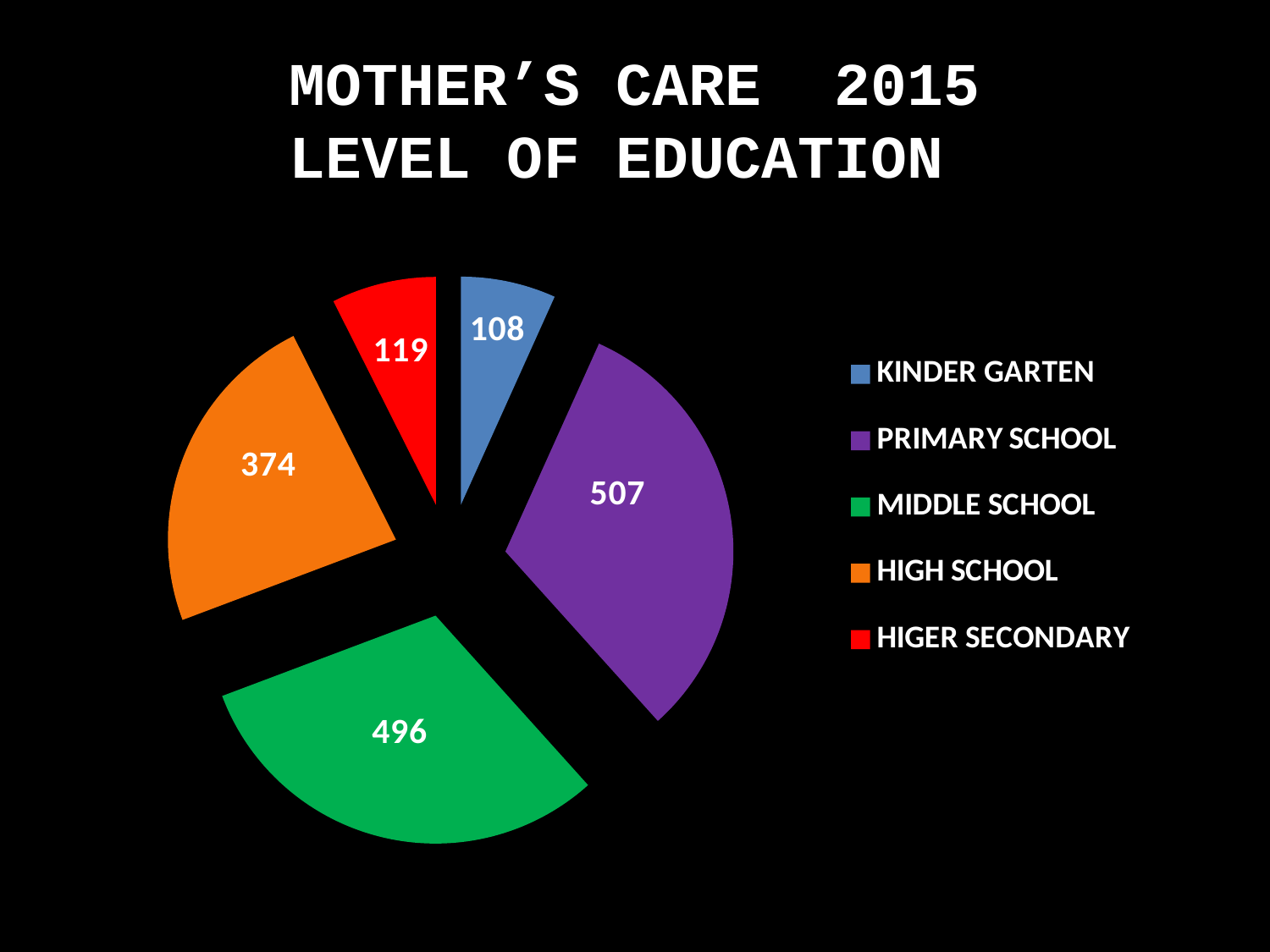
What is the difference between the values for PRIMARY SCHOOL and MIDDLE SCHOOL? 11 What is the value for KINDER GARTEN? 108 What is the value for HIGER SECONDARY? 119 What colour is the MIDDLE SCHOOL slice? Green What is the value for MIDDLE SCHOOL? 496 What is the value for HIGH SCHOOL? 374 Which is larger, the value for HIGH SCHOOL or the value for HIGER SECONDARY? HIGH SCHOOL Which category has the lowest value? KINDER GARTEN What kind of chart is shown on the slide? Pie chart Which category has the highest value? PRIMARY SCHOOL What is the value for PRIMARY SCHOOL? 507 How many categories does the pie chart show? 5